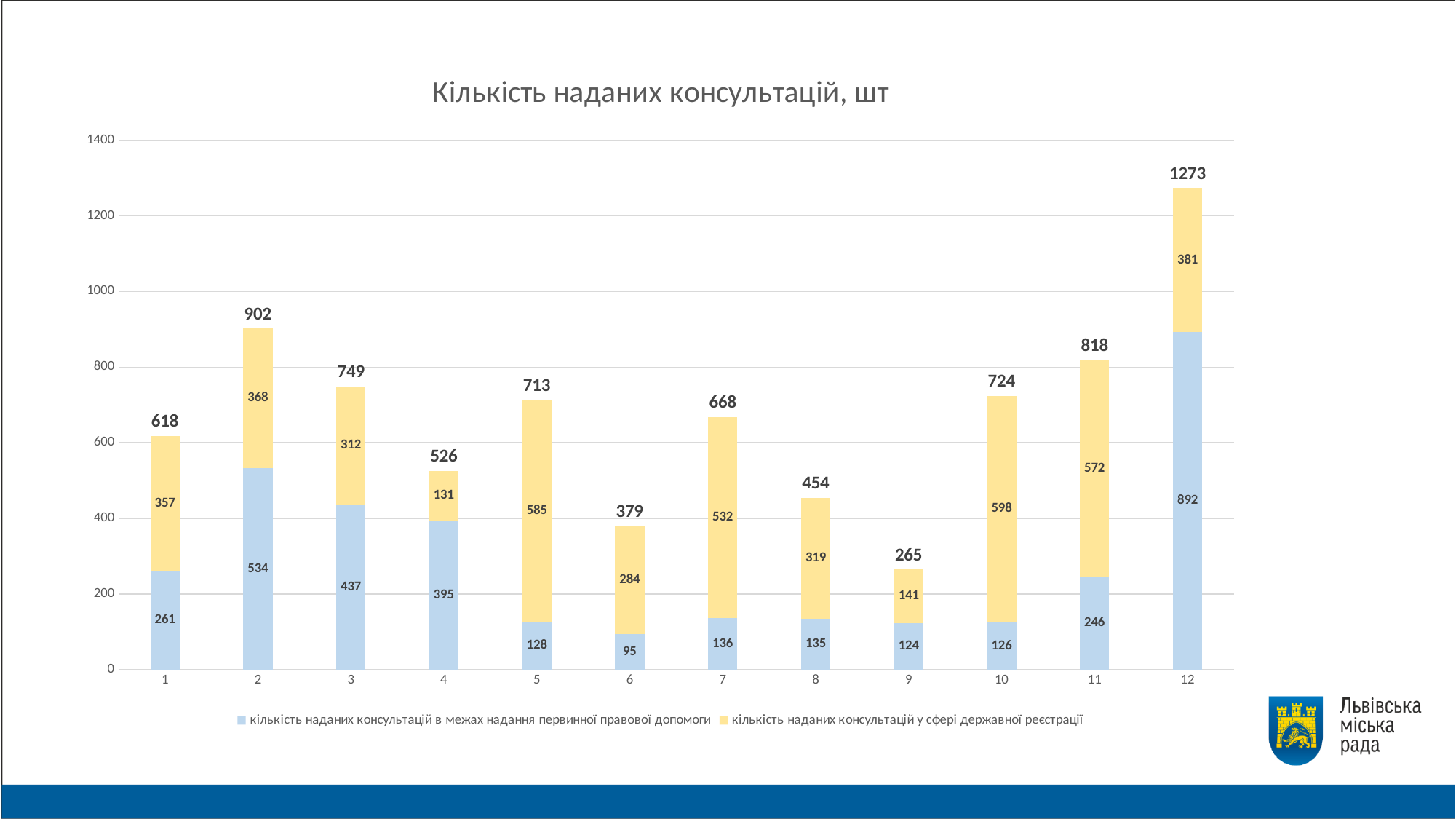
Which is larger: the 'кількість наданих консультацій у сфері державної реєстрації' value for category 10 or for category 7? Category 10 Is the total for category 3 greater or less than 800? less How many series does the legend list? 2 What type of chart is shown on the slide? Stacked bar chart What is the value of 'кількість наданих консультацій у сфері державної реєстрації' for category 5? 585 Which category has the lowest total? 9 What is the value of 'кількість наданих консультацій в межах надання первинної правової допомоги' for category 12? 892 What is the title of the chart? Кількість наданих консультацій, шт What is the difference between the totals for category 11 and category 10? 94 What is the total of the stacked bar for category 2? 902 How many categories are shown on the x axis? 12 Which category has the highest total? 12